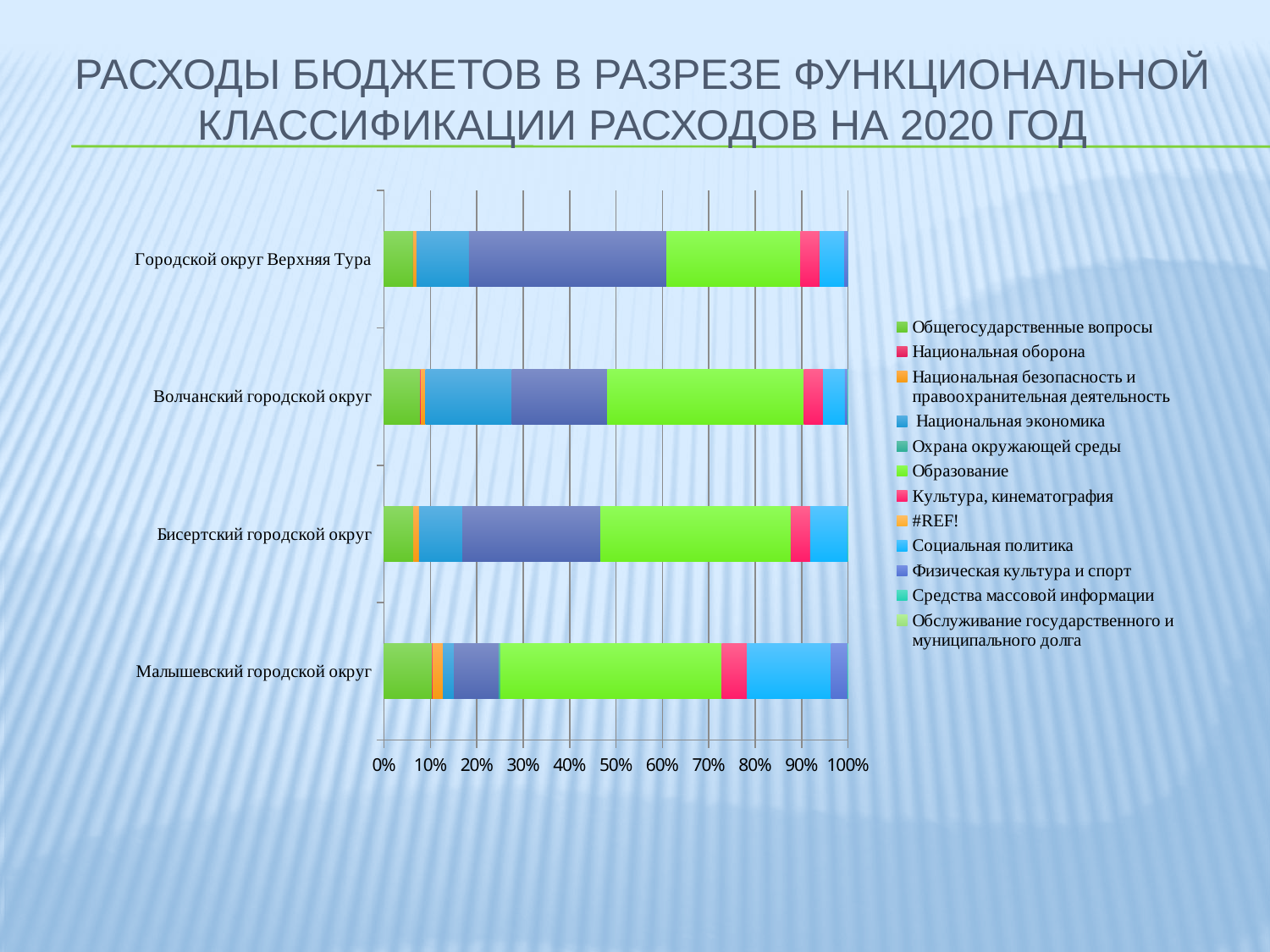
Which municipality has the smallest share for Образование? Городской округ Верхняя Тура Is the share of Образование for Малышевский городской округ greater or less than 40%? greater What kind of chart is shown on the slide? Stacked bar chart Which municipality has the largest share for Социальная политика? Малышевский городской округ Which legend entry appears as an error text instead of a category name? #REF! How many series does the legend list? 12 How many municipalities (bars) are shown in the chart? 4 Which is larger for Волчанский городской округ: the share of Образование or the share of Национальная экономика? Образование What is the title of the slide? РАСХОДЫ БЮДЖЕТОВ В РАЗРЕЗЕ ФУНКЦИОНАЛЬНОЙ КЛАССИФИКАЦИИ РАСХОДОВ НА 2020 ГОД